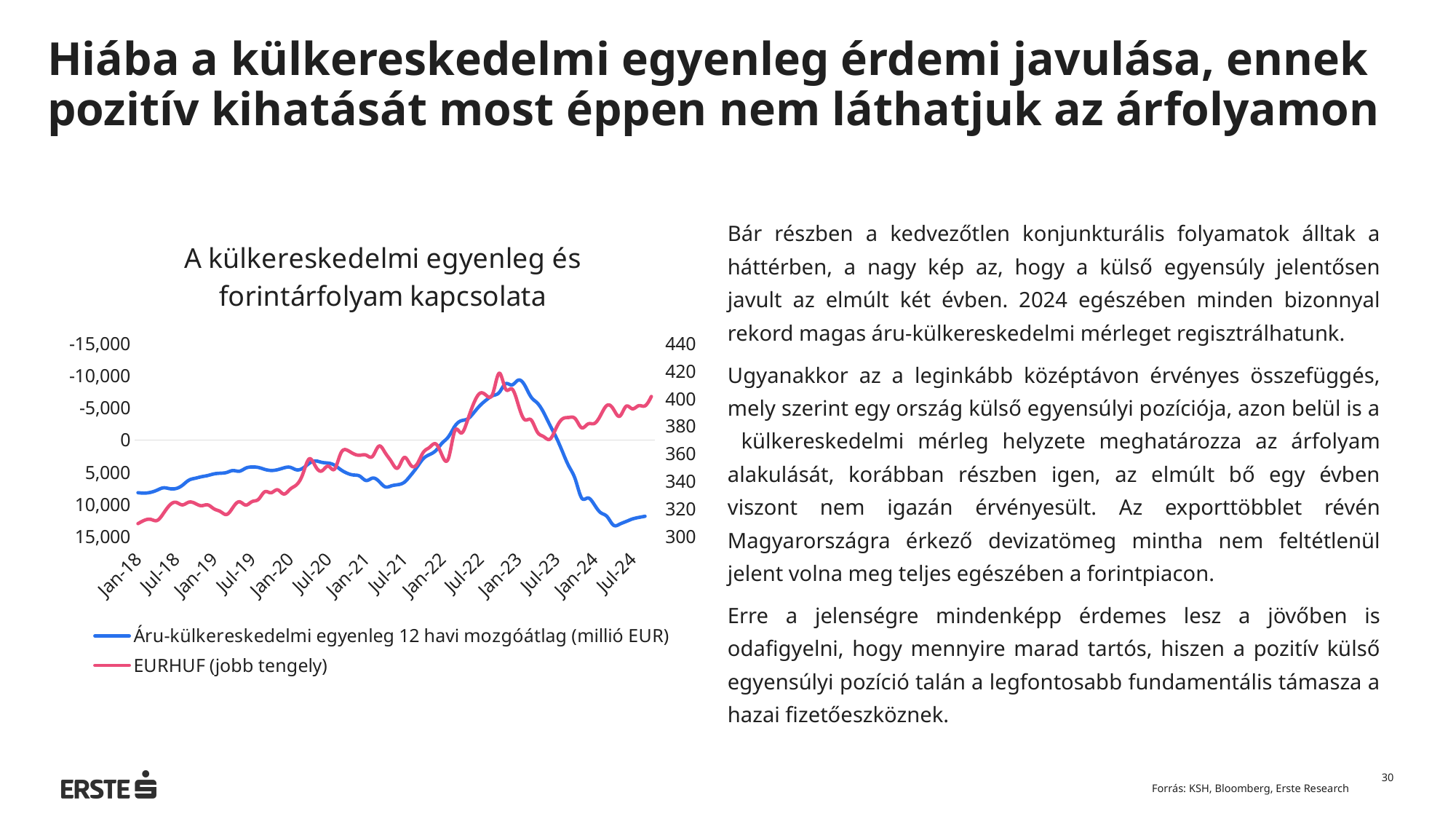
Is the EURHUF value at its peak around Jan-23 greater or less than 400? greater What is the highest tick value shown on the right axis? 440 Is the EURHUF value at Jan-18 greater or less than 320? less What kind of chart is shown on the slide? Line chart What is the title of the chart? A külkereskedelmi egyenleg és forintárfolyam kapcsolata How many date labels are shown on the x axis of the chart? 14 What is the lowest tick value shown on the right axis? 300 Reading the left axis, is the Áru-külkereskedelmi egyenleg 12 havi mozgóátlag value at Jul-24 greater or less than 10,000? greater How many series does the chart legend list? 2 Which series is plotted on the right axis according to the legend? EURHUF (jobb tengely) What is the first date label on the x axis? Jan-18 Does the EURHUF series rise or fall overall from Jan-18 to Jul-24? rise